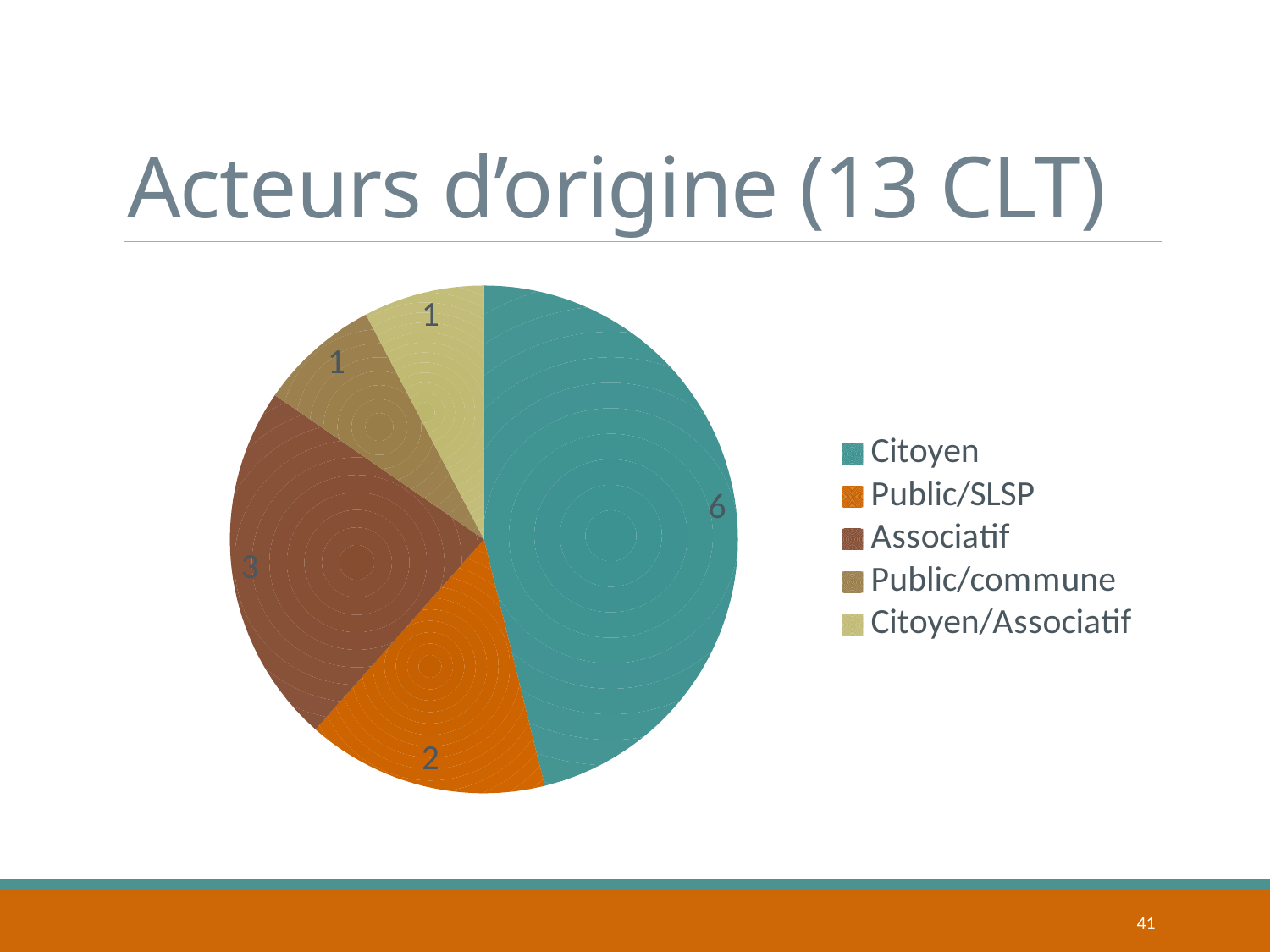
What type of chart is shown on the slide? Pie chart What is the value for Citoyen? 6 Which is larger, the value for Associatif or the value for Public/SLSP? Associatif What is the title of the chart? Acteurs d'origine (13 CLT) What is the value for Associatif? 3 What is the value for Public/commune? 1 Which category has the largest slice? Citoyen What is the value for Public/SLSP? 2 What is the total of all slices in the pie? 13 What is the difference between the values for Citoyen and Associatif? 3 Which categories have the smallest slices? Public/commune and Citoyen/Associatif How many categories does the legend list? 5